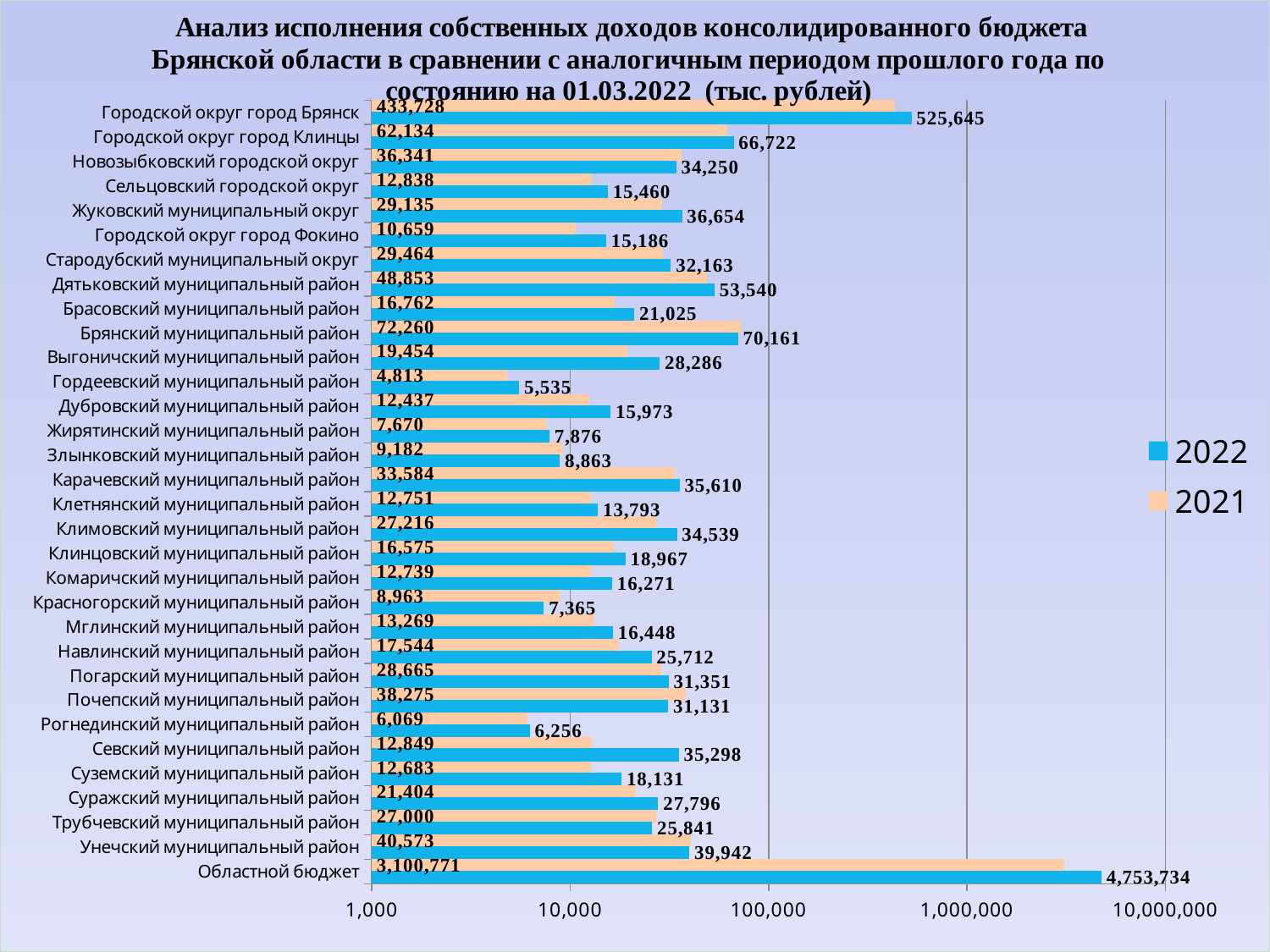
Which series is shown in blue in the legend? 2022 What is the 2021 value for Брянский муниципальный район? 72,260 How many series does the legend list? 2 What is the difference between the 2022 and 2021 values for Севский муниципальный район? 22,449 How many categories are shown on the chart? 32 What is the 2022 value for Севский муниципальный район? 35,298 What is the 2022 value for Городской округ город Брянск? 525,645 What kind of chart is shown on the slide? Bar chart Which category has the highest 2022 value? Областной бюджет Which is larger for Почепский муниципальный район, the 2021 value or the 2022 value? 2021 What is the 2021 value for Областной бюджет? 3,100,771 Which category has the lowest 2021 value? Гордеевский муниципальный район